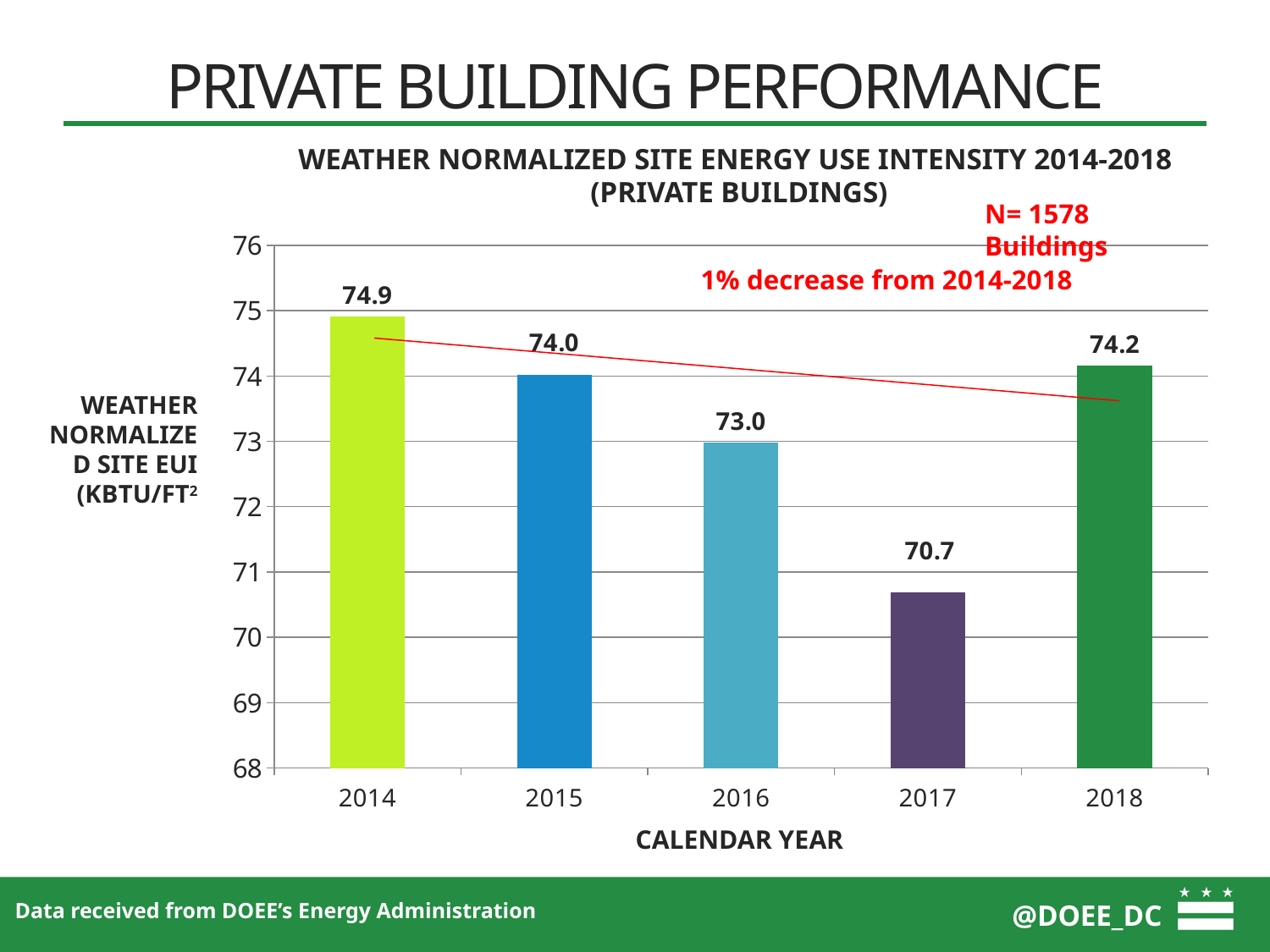
Which calendar year has the lowest weather normalized site EUI? 2017 According to the red annotation, what is the percentage change from 2014 to 2018? 1% decrease What is the weather normalized site EUI value for 2017? 70.7 Which calendar year has the highest weather normalized site EUI? 2014 What is the weather normalized site EUI value for 2014? 74.9 Which year has a larger value, 2015 or 2018? 2018 What is the difference between the 2016 value and the 2017 value? 2.3 Is the value for 2017 greater or less than 71? less What is the weather normalized site EUI value for 2018? 74.2 What kind of chart is shown on the slide? bar chart How many calendar years are shown on the chart? 5 What is the difference between the 2014 value and the 2018 value? 0.7